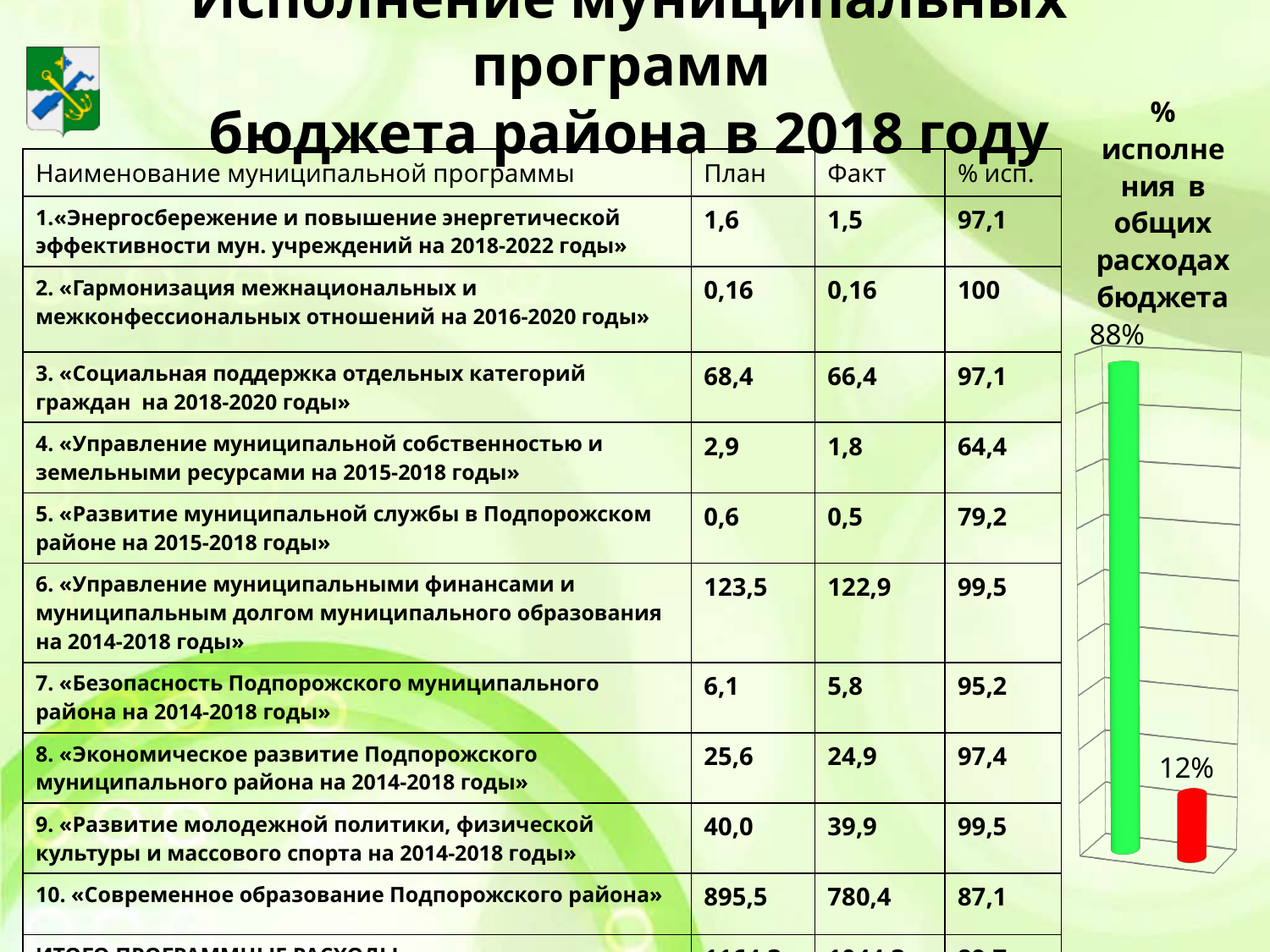
What is the title of the chart on the right of the slide? % исполнения в общих расходах бюджета What colour is the bar labelled 12% in the chart on the right of the slide? red What is the difference in percentage points between the green bar and the red bar in the chart on the right of the slide? 76 In the chart on the right of the slide, which bar is taller, the green one or the red one? the green one What do the two bars in the chart on the right of the slide add up to? 100% What value is shown on the red bar in the chart on the right of the slide? 12% How many bars are plotted in the chart on the right of the slide? 2 In the chart on the right of the slide, which bar has the lowest value? the red bar (12%) What value is shown on the green bar in the chart on the right of the slide? 88% What type of chart is shown on the right of the slide? bar chart In the chart on the right of the slide, which bar has the highest value? the green bar (88%)